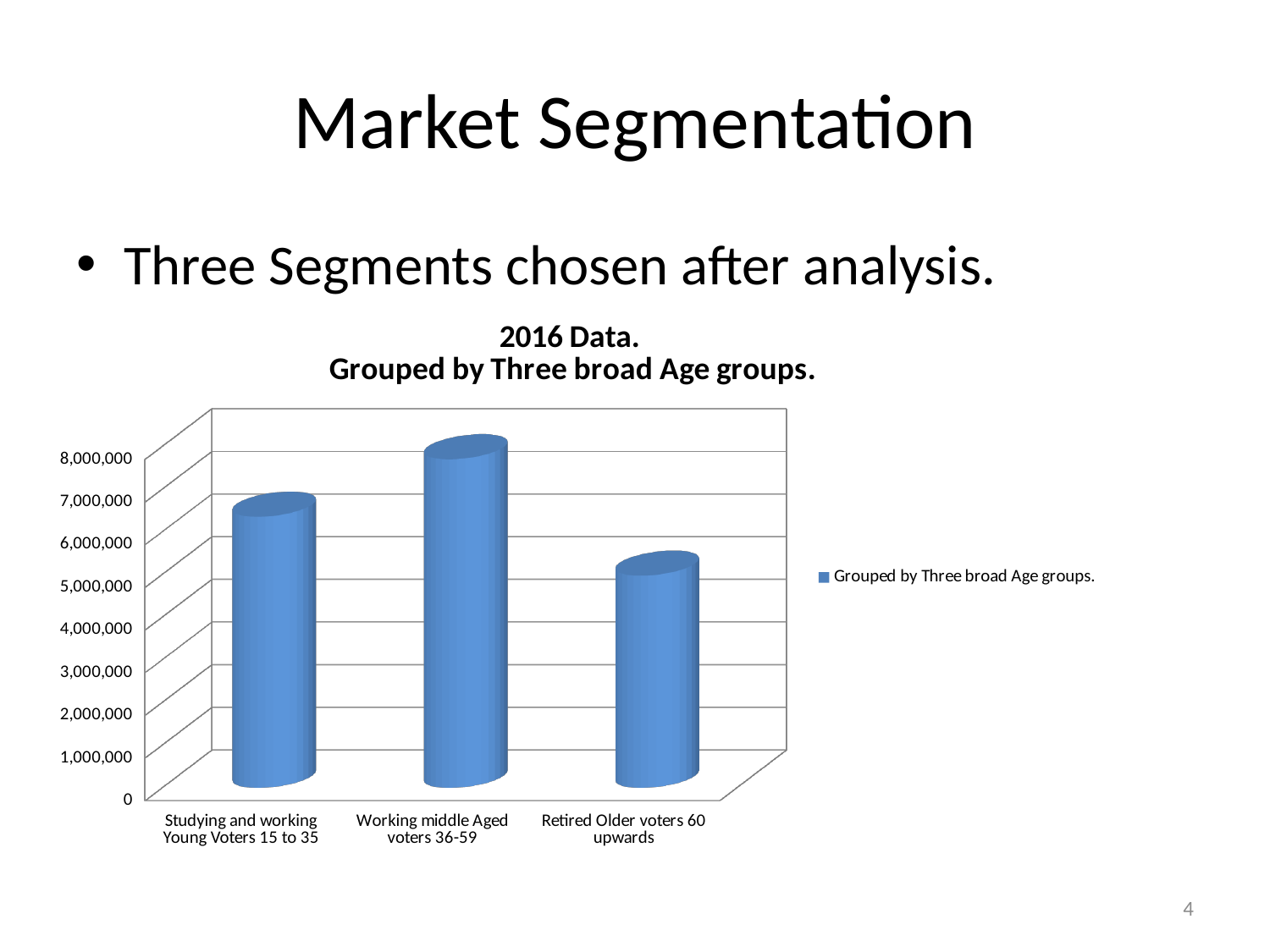
Which age group has the highest value on the chart? Working middle Aged voters 36-59 Is the value for Studying and working Young Voters 15 to 35 greater or less than 6,000,000? greater What colour are the bars in the chart? Blue Is the value for Retired Older voters 60 upwards greater or less than 6,000,000? less What kind of chart is shown on the slide? Bar chart Which is larger: the value for Studying and working Young Voters 15 to 35 or the value for Retired Older voters 60 upwards? Studying and working Young Voters 15 to 35 Is the value for Studying and working Young Voters 15 to 35 greater or less than 7,000,000? less Which age group has the lowest value on the chart? Retired Older voters 60 upwards What is the title of the chart? 2016 Data. Grouped by Three broad Age groups. How many series does the chart's legend list? 1 How many age-group categories are plotted on the chart? 3